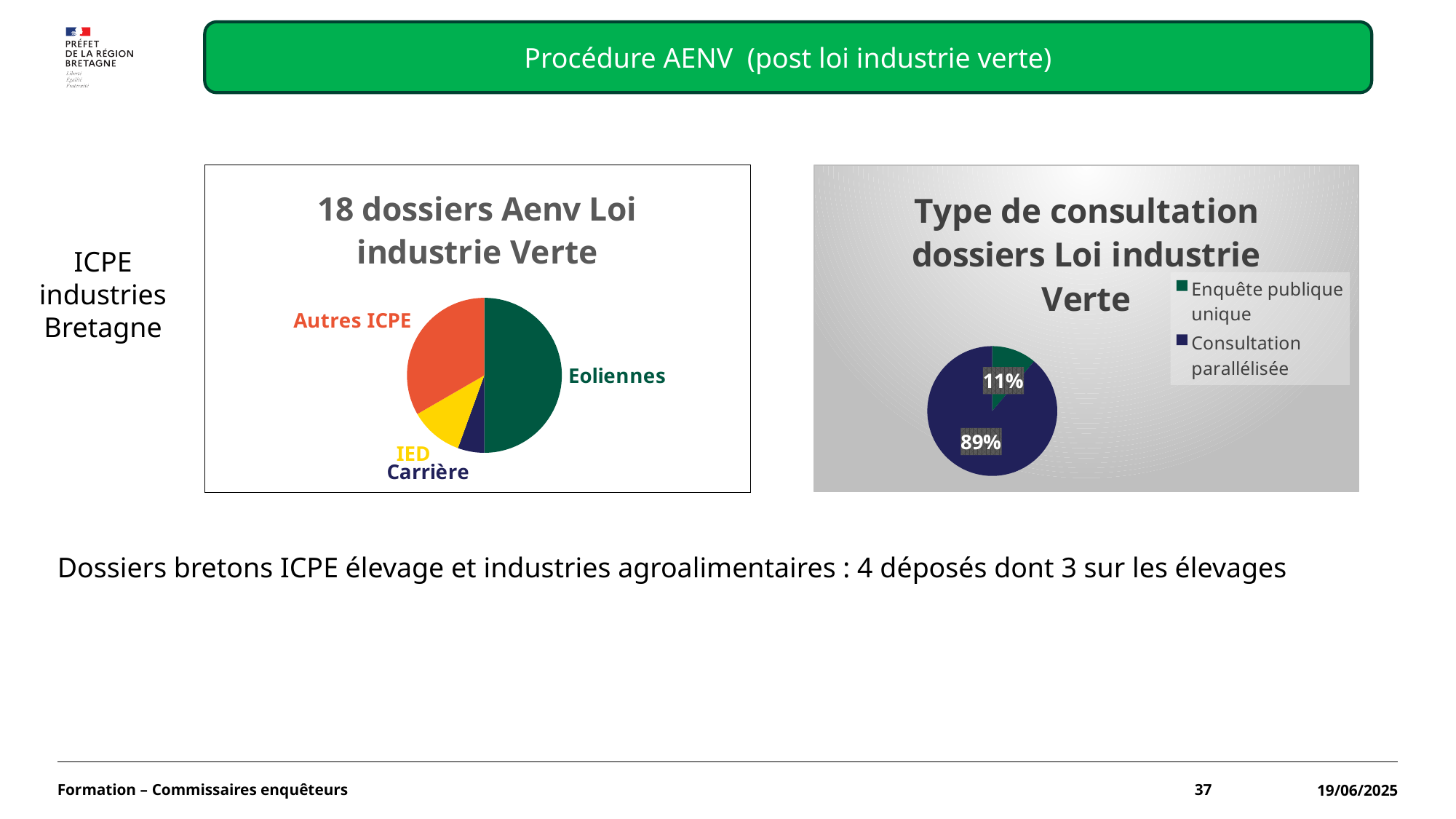
In the left pie chart '18 dossiers Aenv Loi industrie Verte', which category has the largest slice? Eoliennes In the left pie chart '18 dossiers Aenv Loi industrie Verte', which slice is larger: IED or Carrière? IED In the right pie chart 'Type de consultation dossiers Loi industrie Verte', what percentage is shown for Enquête publique unique? 11% In the right pie chart 'Type de consultation dossiers Loi industrie Verte', what is the difference in percentage points between Consultation parallélisée and Enquête publique unique? 78 percentage points How many entries does the legend of the right pie chart 'Type de consultation dossiers Loi industrie Verte' list? 2 In the left pie chart '18 dossiers Aenv Loi industrie Verte', which slice is larger: Autres ICPE or IED? Autres ICPE What kind of chart is the left chart titled '18 dossiers Aenv Loi industrie Verte'? pie chart In the right pie chart 'Type de consultation dossiers Loi industrie Verte', which type of consultation has the largest share? Consultation parallélisée What is the title of the left pie chart? 18 dossiers Aenv Loi industrie Verte In the right pie chart 'Type de consultation dossiers Loi industrie Verte', what percentage is shown for Consultation parallélisée? 89% How many categories does the left pie chart '18 dossiers Aenv Loi industrie Verte' show? 4 In the left pie chart '18 dossiers Aenv Loi industrie Verte', which category has the smallest slice? Carrière